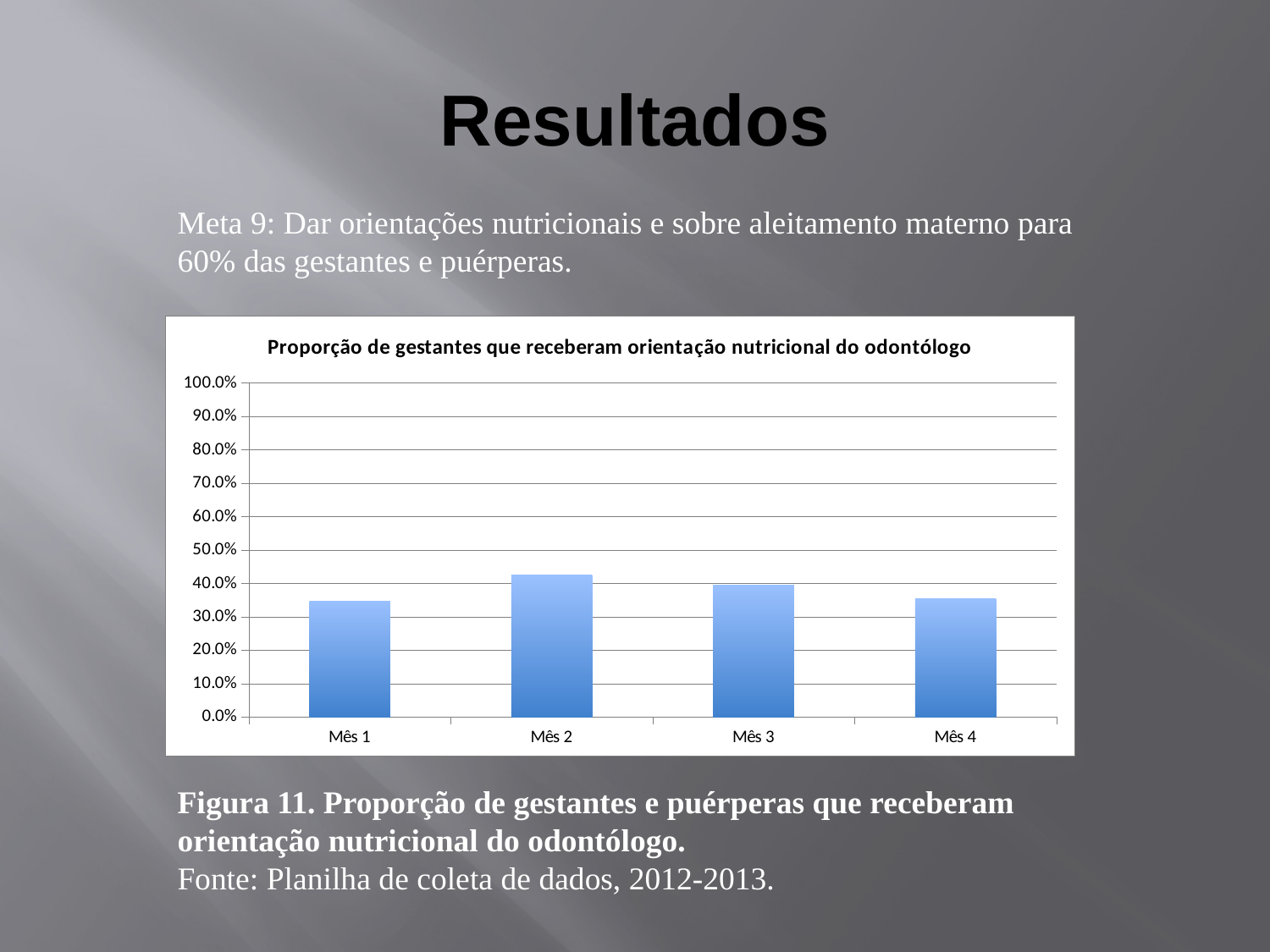
What kind of chart is shown on the slide? bar chart Do the values rise or fall from Mês 2 to Mês 4? fall Is the value for Mês 3 greater or less than 30.0%? greater Is the value for Mês 2 greater or less than 40.0%? greater Which is larger, the value for Mês 2 or the value for Mês 1? Mês 2 Is the value for Mês 2 greater or less than 60.0%? less How many months (categories) are shown on the x axis of the chart? 4 Which month has the highest proportion in the chart? Mês 2 Which is larger, the value for Mês 3 or the value for Mês 4? Mês 3 What is the title of the chart? Proporção de gestantes que receberam orientação nutricional do odontólogo